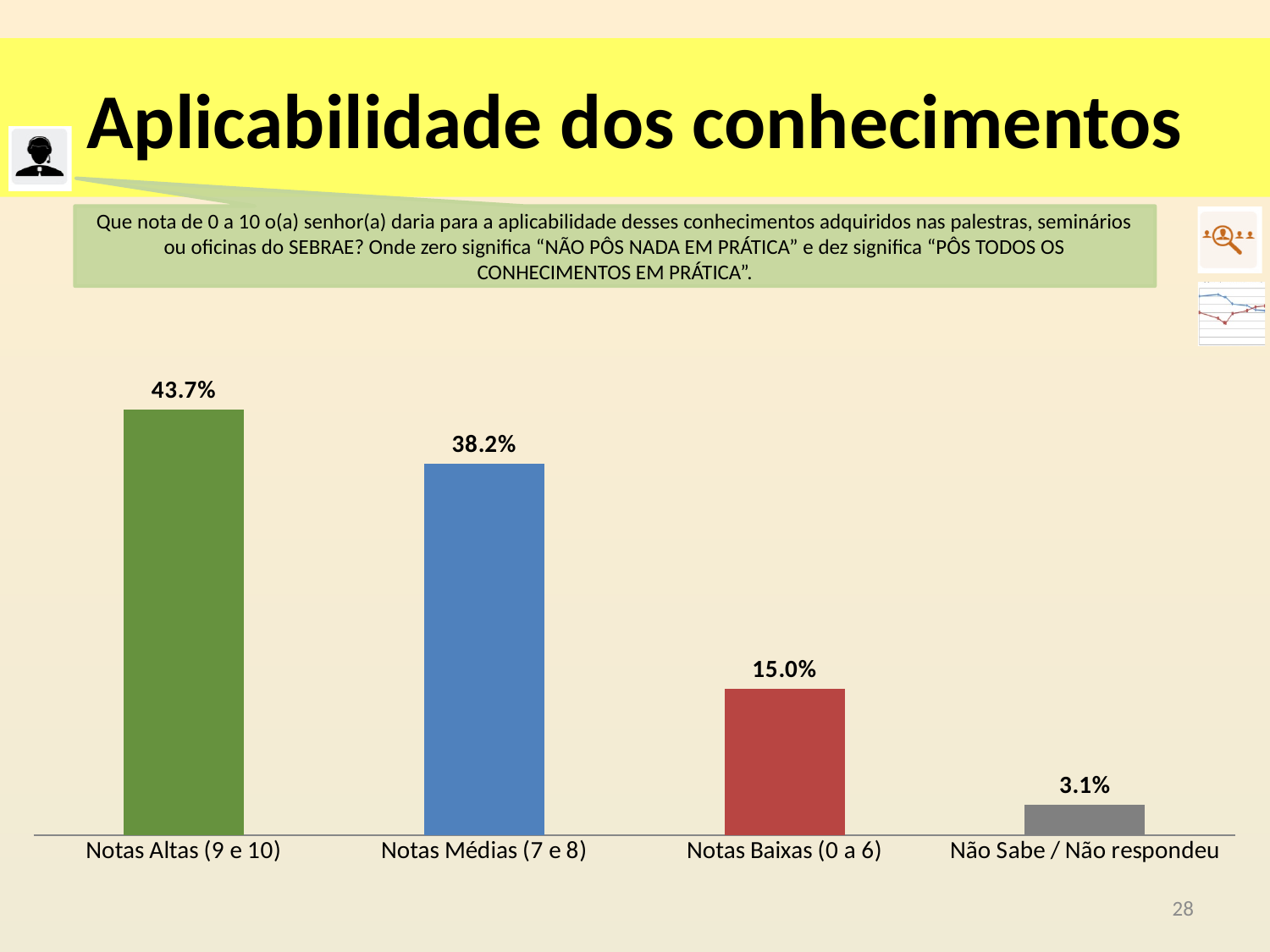
Do the values rise or fall from left to right across the categories? Fall Which category has the highest value? Notas Altas (9 e 10) What is the value for Notas Médias (7 e 8)? 38.2% What is the value for Não Sabe / Não respondeu? 3.1% What is the value for Notas Baixas (0 a 6)? 15.0% What is the difference between the values for Notas Baixas (0 a 6) and Não Sabe / Não respondeu? 11.9% Which category has the lowest value? Não Sabe / Não respondeu What kind of chart is shown on the slide? Bar chart What is the difference between the values for Notas Altas (9 e 10) and Notas Médias (7 e 8)? 5.5% Which is larger, the value for Notas Médias (7 e 8) or the value for Notas Baixas (0 a 6)? Notas Médias (7 e 8) How many categories are shown in the chart? 4 What is the value for Notas Altas (9 e 10)? 43.7%